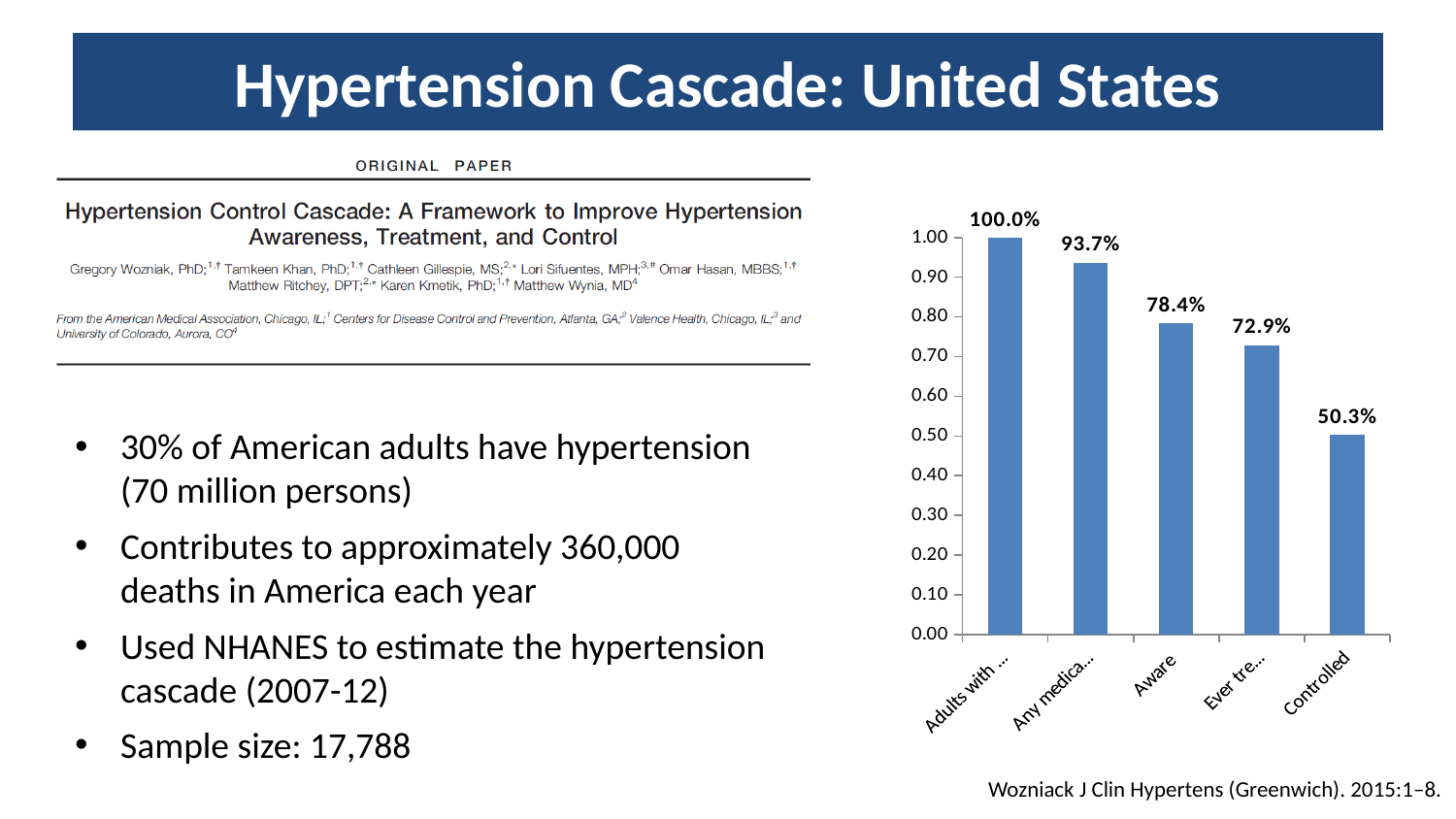
What is the value shown for the Aware bar? 78.4% Is the value for Controlled greater or less than 0.60 on the axis? less Which category has the lowest value in the chart? Controlled Do the bar values rise or fall from left to right across the chart? fall What is the value shown on the second bar from the left? 93.7% What is the value shown for the Controlled bar? 50.3% What is the value shown on the first (leftmost) bar of the chart? 100.0% How many bars are plotted in the chart? 5 What is the difference between the Aware value and the Controlled value? 28.1% Which is larger, the value for Aware or the value for Controlled? Aware What type of chart is shown on the slide? bar chart What is the value shown on the fourth bar from the left? 72.9%